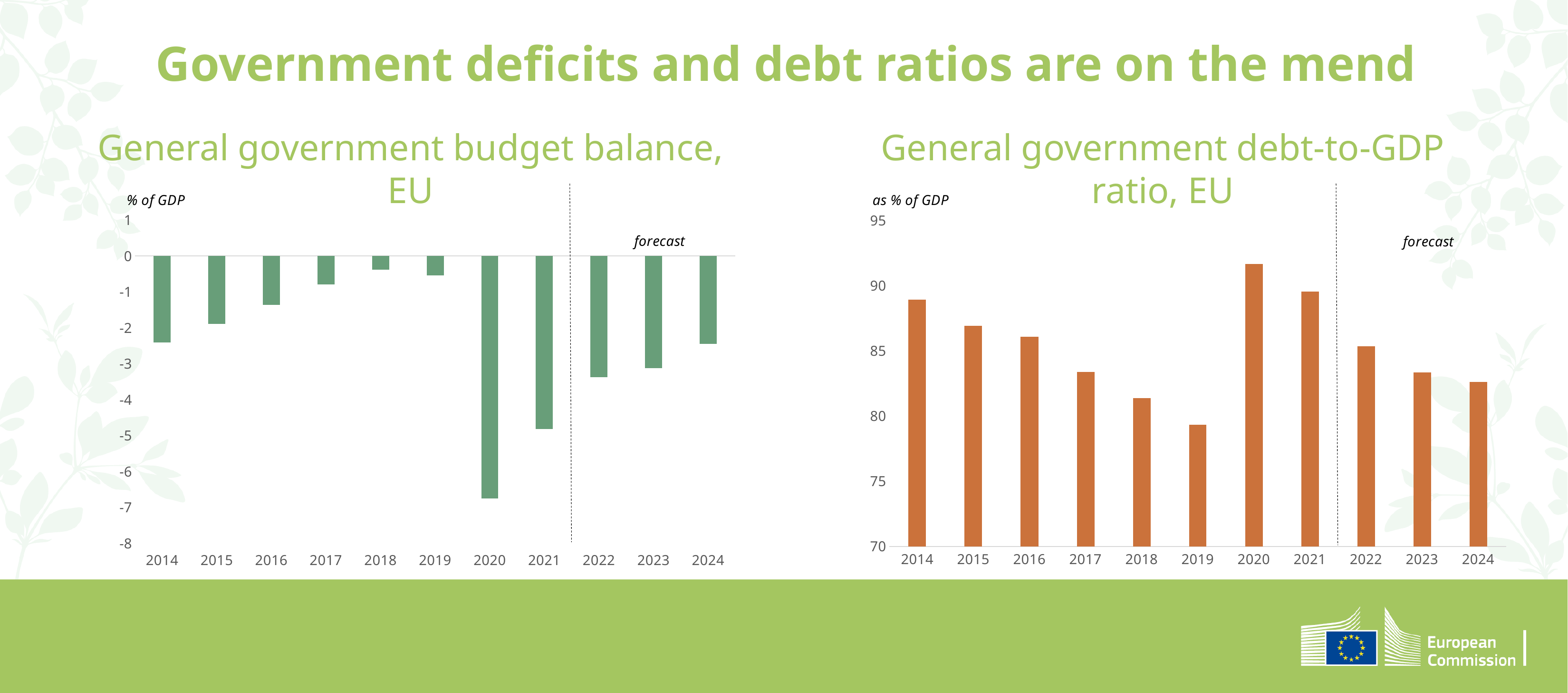
On the 'General government debt-to-GDP ratio, EU' chart, do the values rise or fall from 2021 to 2024? fall On the 'General government budget balance, EU' chart, how many years are shown on the x axis? 11 On the 'General government debt-to-GDP ratio, EU' chart, is the value for 2019 greater or less than 80? less On the 'General government debt-to-GDP ratio, EU' chart, which year has the lowest value? 2019 On the 'General government budget balance, EU' chart, is the value for 2020 greater or less than -6? less On the 'General government debt-to-GDP ratio, EU' chart, which year has the highest value? 2020 On the 'General government budget balance, EU' chart, is the value for 2021 greater or less than -4? less On the 'General government budget balance, EU' chart, which year has the value closest to zero? 2018 On the 'General government budget balance, EU' chart, which year has the lowest (most negative) value? 2020 What kind of chart is the 'General government debt-to-GDP ratio, EU' chart? bar chart On the 'General government debt-to-GDP ratio, EU' chart, which is larger, the value for 2014 or the value for 2017? 2014